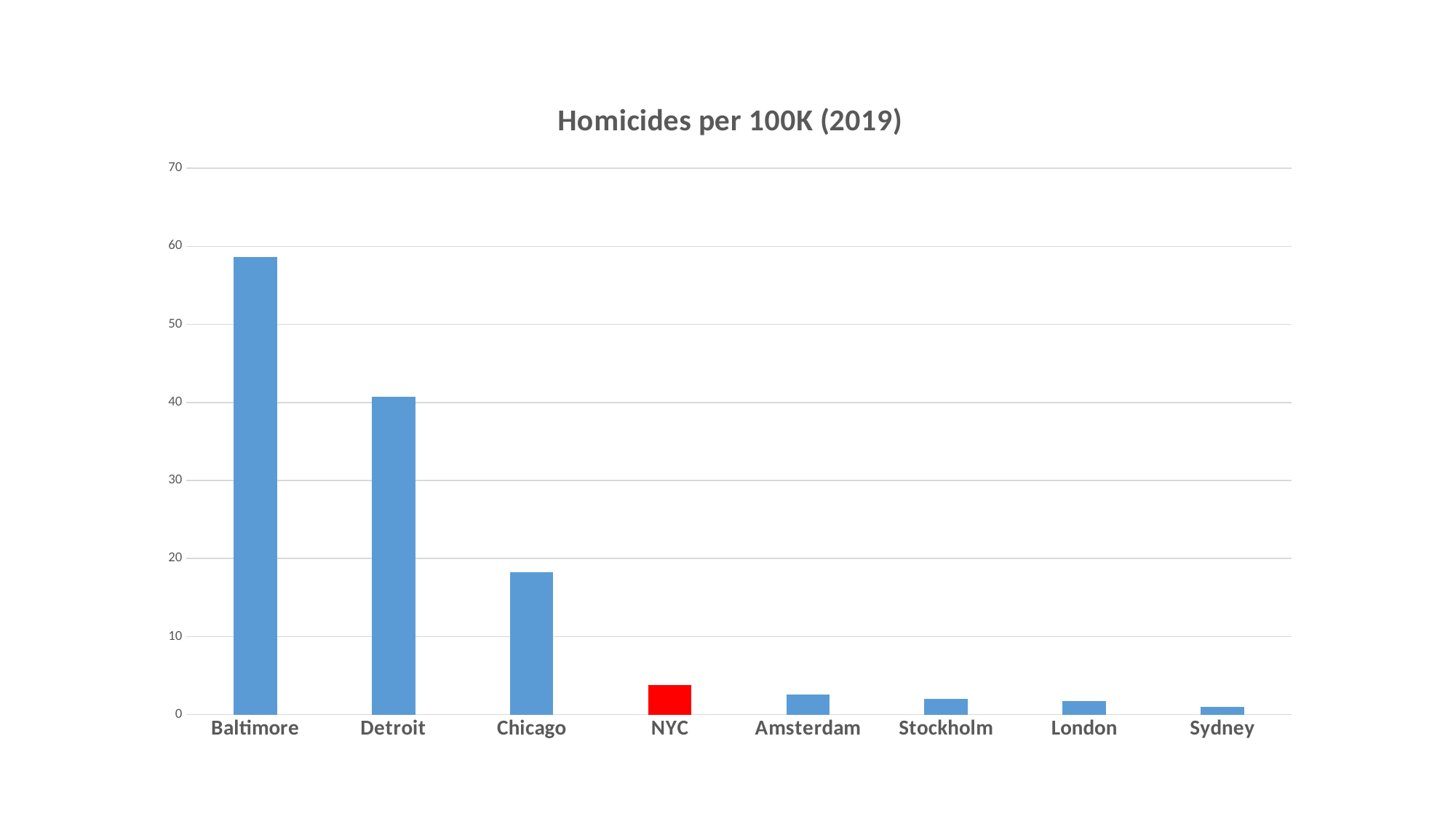
Is the value for Baltimore greater or less than 50? greater Is the value for Detroit greater or less than 50? less Which city's bar is coloured red? NYC Which city has the lowest homicides per 100K? Sydney What is the title of the chart? Homicides per 100K (2019) Is the value for NYC greater or less than 10? less What kind of chart is shown on the slide? bar chart Which city has a higher value, Detroit or Chicago? Detroit Which city has the highest homicides per 100K? Baltimore Which city has a higher value, NYC or London? NYC How many cities are shown on the x axis of the chart? 8